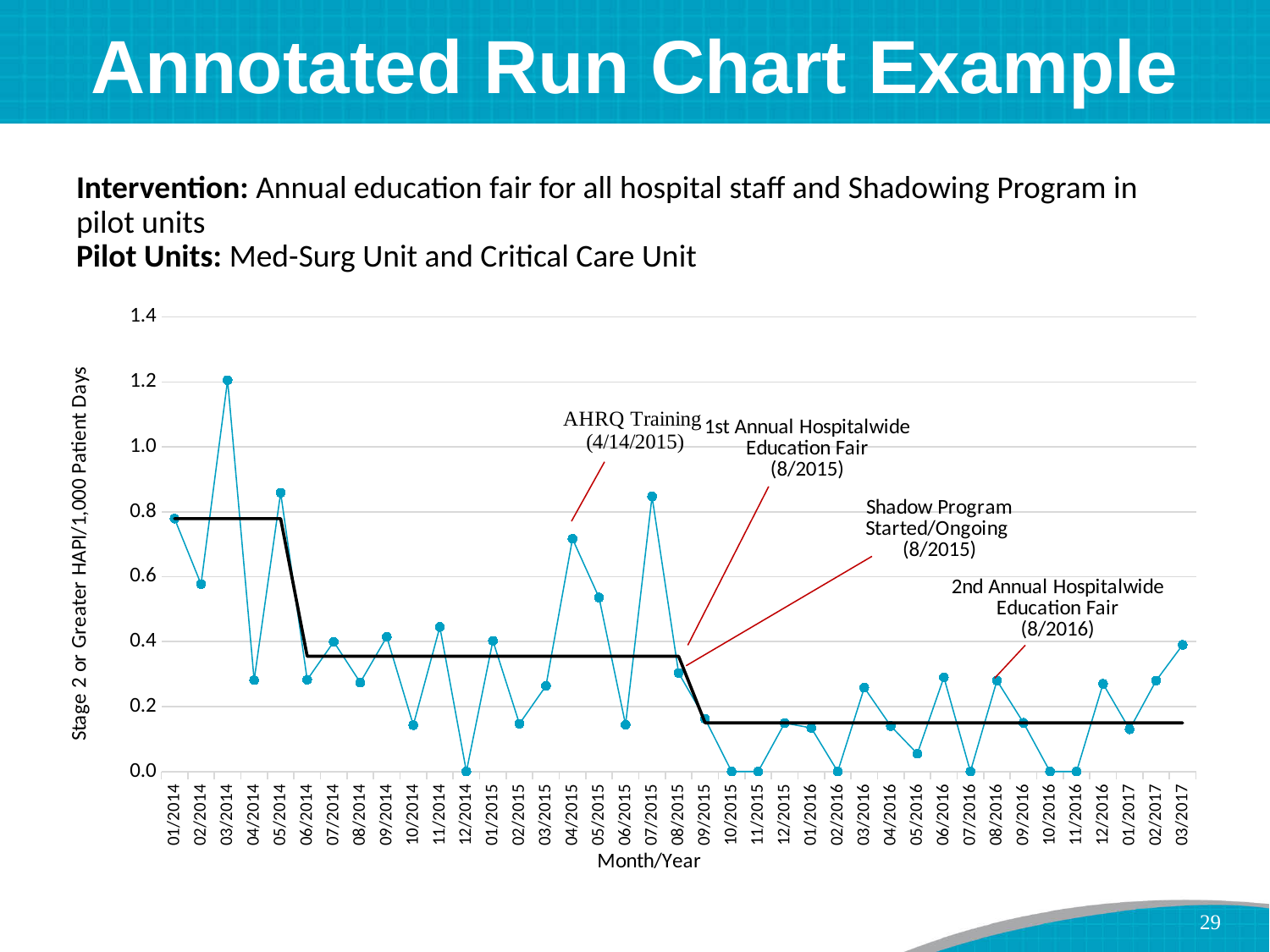
Is the value for 04/2015 greater or less than 0.6? greater What is the title of the x axis? Month/Year Which month has the highest Stage 2 or Greater HAPI/1,000 Patient Days value? 03/2014 Which is larger, the value for 03/2014 or the value for 07/2015? 03/2014 What is the value plotted for 12/2014? 0.0 What kind of chart is shown on the slide? line chart Do the values generally rise or fall from 01/2014 to 03/2017? fall Is the value for 05/2014 greater or less than 0.8? greater How many months are plotted along the x axis? 39 Is the value for 03/2014 greater or less than 1.0? greater